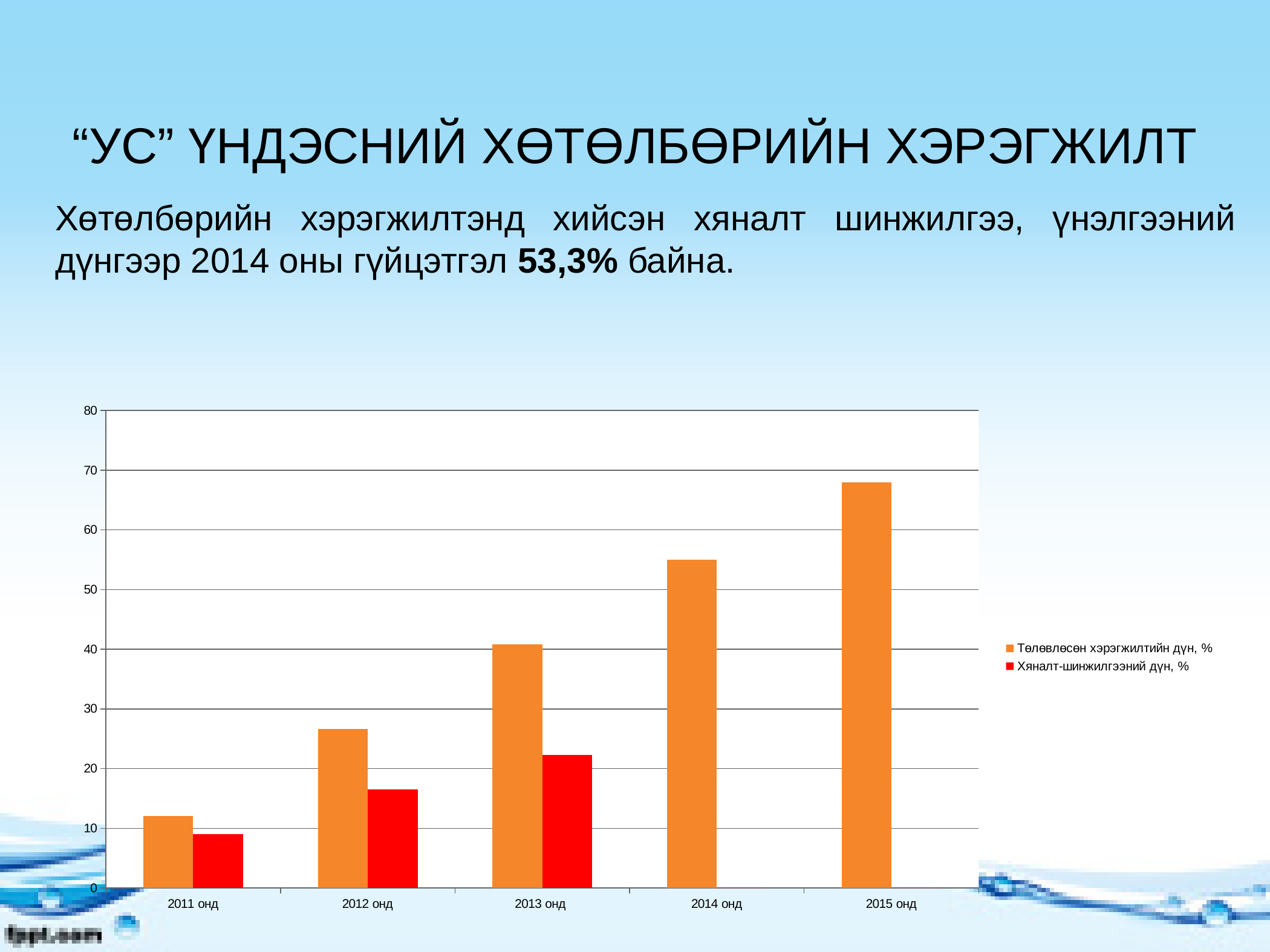
Do the values for Төлөвлөсөн хэрэгжилтийн дүн, % rise or fall from 2011 онд to 2015 онд? rise Which year has the lowest value for Төлөвлөсөн хэрэгжилтийн дүн, %? 2011 онд What colour are the bars for Хяналт-шинжилгээний дүн, %? red Which year has the highest value for Төлөвлөсөн хэрэгжилтийн дүн, %? 2015 онд Is the value for Хяналт-шинжилгээний дүн, % in 2011 онд greater or less than 10? less Is the value for Төлөвлөсөн хэрэгжилтийн дүн, % in 2012 онд greater or less than 30? less What kind of chart is shown on the slide? bar chart Is the value for Хяналт-шинжилгээний дүн, % in 2012 онд greater or less than 20? less In 2013 онд, which is larger: Төлөвлөсөн хэрэгжилтийн дүн, % or Хяналт-шинжилгээний дүн, %? Төлөвлөсөн хэрэгжилтийн дүн, % How many year categories are shown on the x axis? 5 How many series does the legend list? 2